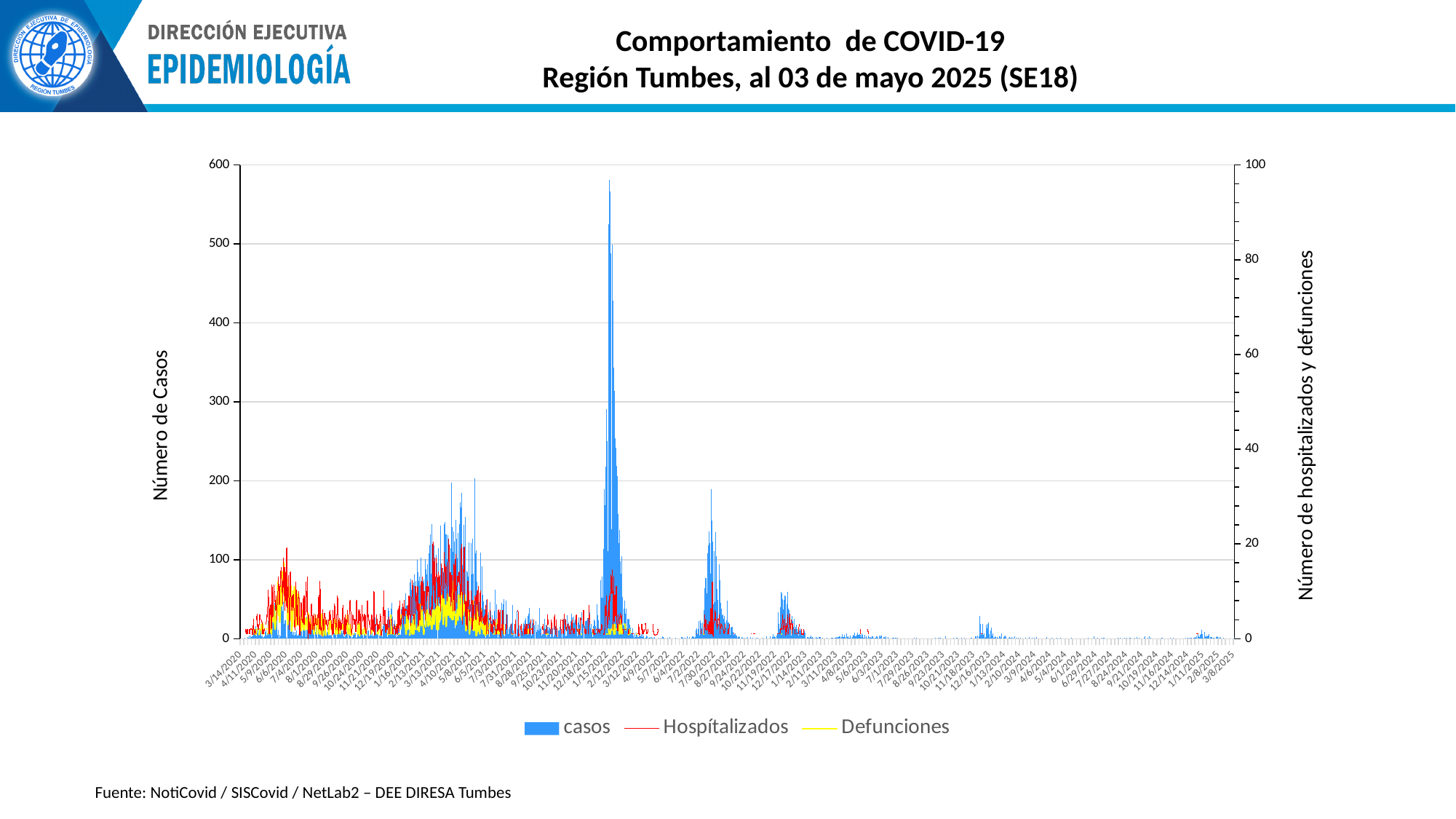
Which series has the higher peak on the right axis, Hospitalizados or Defunciones? Hospitalizados Is the highest peak of the Defunciones series greater or less than 40 on the right axis? less What kind of chart is shown on the slide? Combined bar and line chart What is the maximum value shown on the right vertical axis? 100 Is the highest peak of the Hospitalizados series greater or less than 40 on the right axis? less Which series is plotted as bars? casos In which year does the casos series reach its highest peak? 2022 Do the casos values generally rise or fall from early 2022 to 2025? fall Is the highest peak of the casos series greater or less than 500 on the left axis? greater What is the maximum value shown on the left vertical axis? 600 What is the title of the left vertical axis? Número de Casos How many series does the legend list? 3